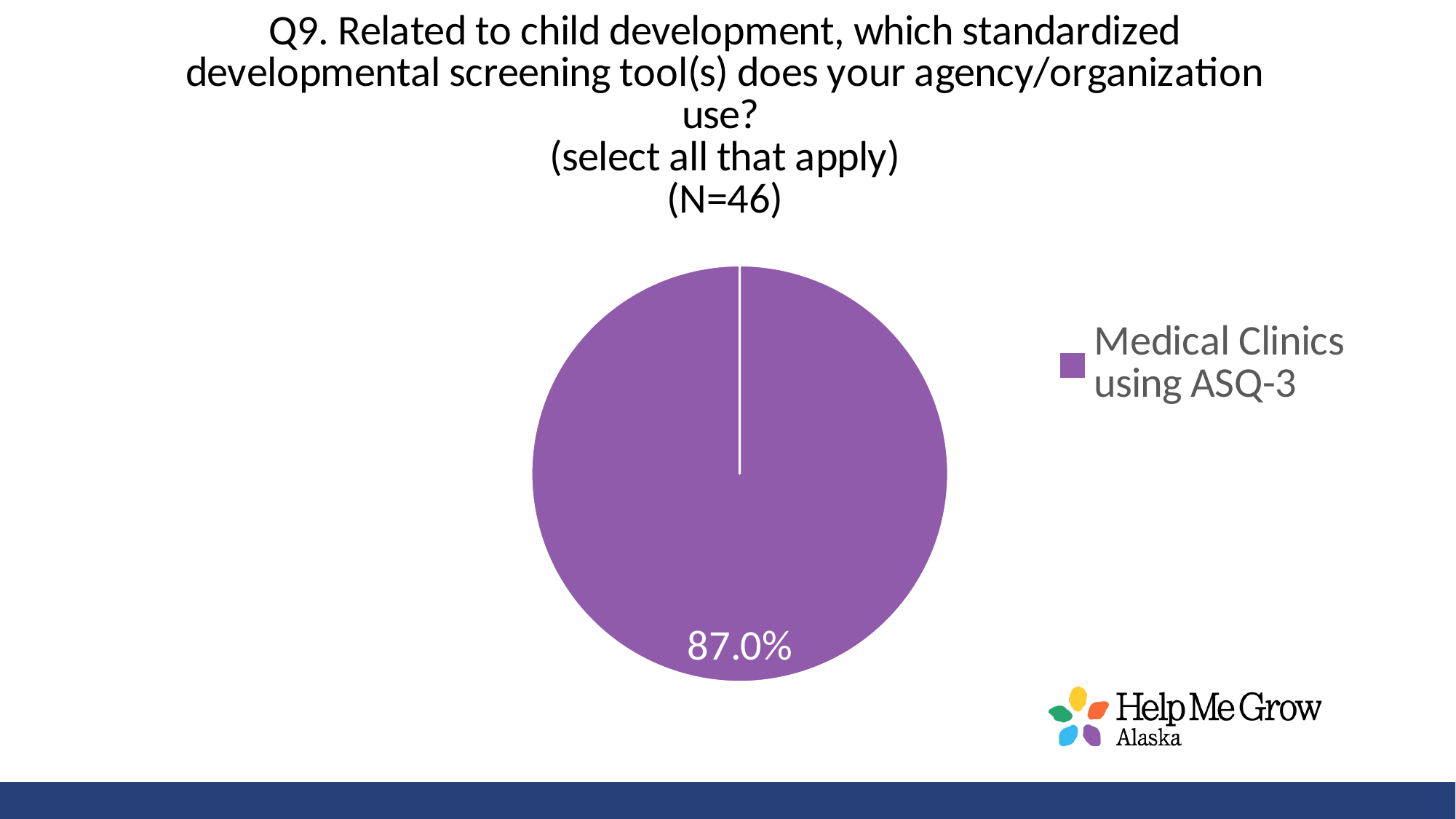
What value is shown for Medical Clinics using ASQ-3? 87.0% What colour is the slice for Medical Clinics using ASQ-3? purple Is the value for Medical Clinics using ASQ-3 greater or less than 50%? greater How many entries does the legend list? 1 What is the label of the only legend entry? Medical Clinics using ASQ-3 What is the sample size (N) stated in the chart title? 46 What kind of chart is shown on the slide? pie chart